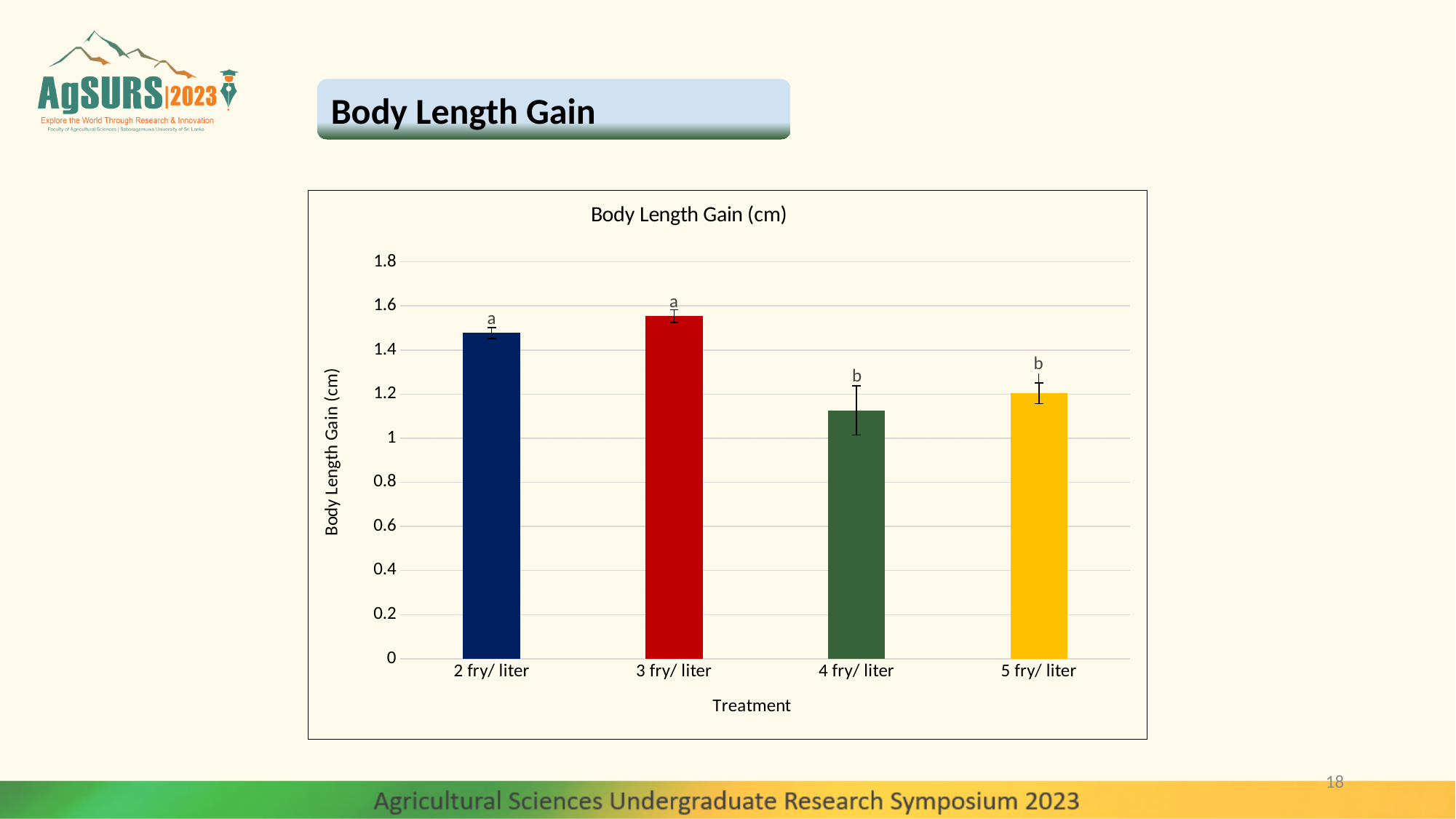
Is the body length gain for 3 fry/ liter greater or less than 1.6? less Which has a larger body length gain, 2 fry/ liter or 4 fry/ liter? 2 fry/ liter What kind of chart is shown on the slide? bar chart How many treatment categories are shown on the x axis? 4 What is the label of the x axis? Treatment Which treatment has the lowest body length gain? 4 fry/ liter Is the body length gain for 4 fry/ liter greater or less than 1? greater Which has a larger body length gain, 5 fry/ liter or 3 fry/ liter? 3 fry/ liter Is the body length gain for 2 fry/ liter greater or less than 1.4? greater What is the title of the chart? Body Length Gain (cm) Which treatment has the highest body length gain? 3 fry/ liter